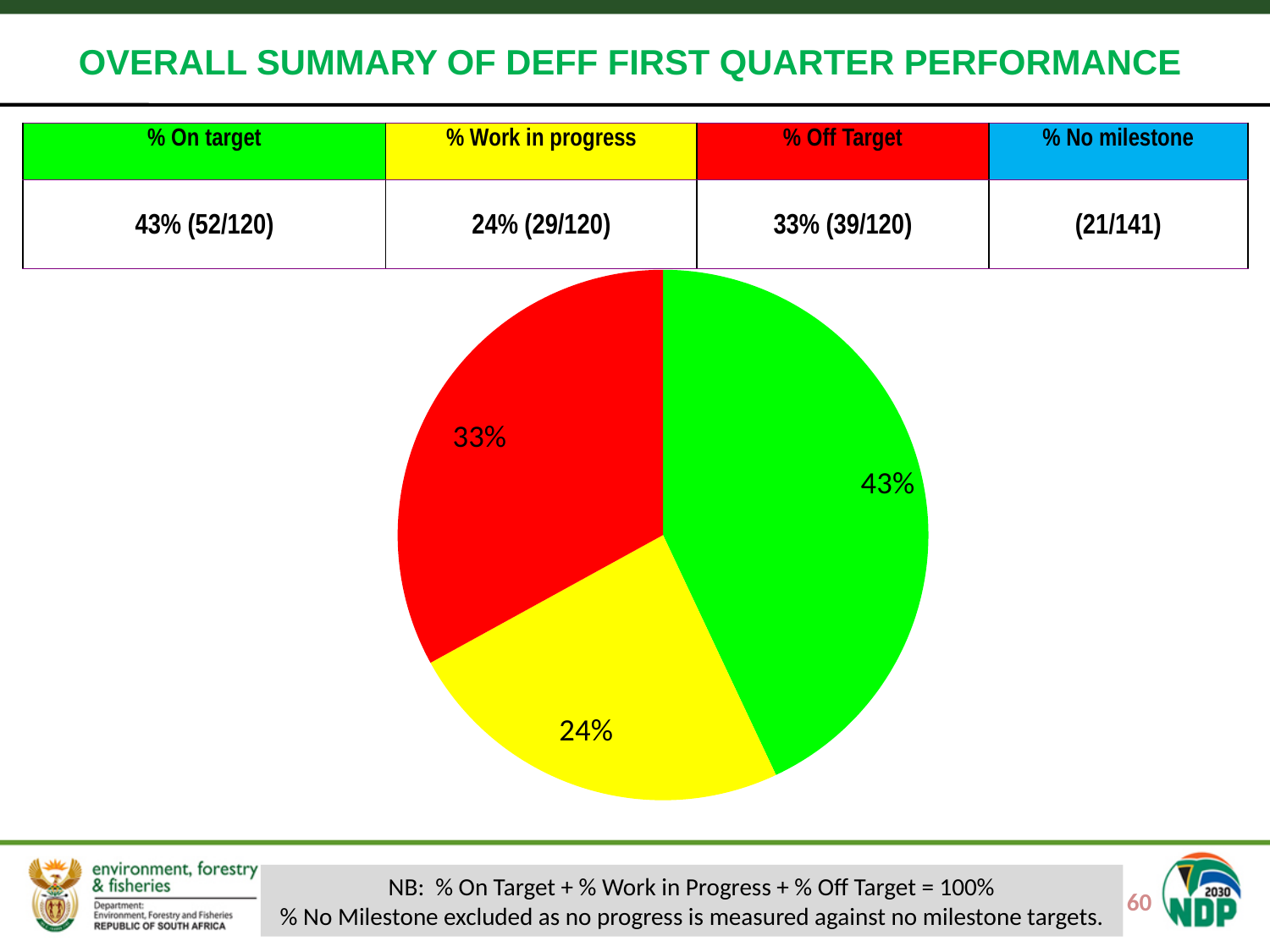
Which is larger in the pie chart, the green slice or the red slice? the green slice (43%) Which slice of the pie chart is the largest? 43% (green, On target) What colour is the On target slice in the pie chart? green What percentage is shown on the yellow slice of the pie chart? 24% What kind of chart is shown on the slide? pie chart What is the difference between the red slice and the yellow slice of the pie chart? 9% How many slices does the pie chart have? 3 What share of the pie does the Off Target slice represent? 33% What is the total of the three percentages shown on the pie chart? 100% What percentage is shown on the green slice of the pie chart? 43% What percentage is shown on the red slice of the pie chart? 33% Which slice of the pie chart is the smallest? 24% (yellow, Work in progress)